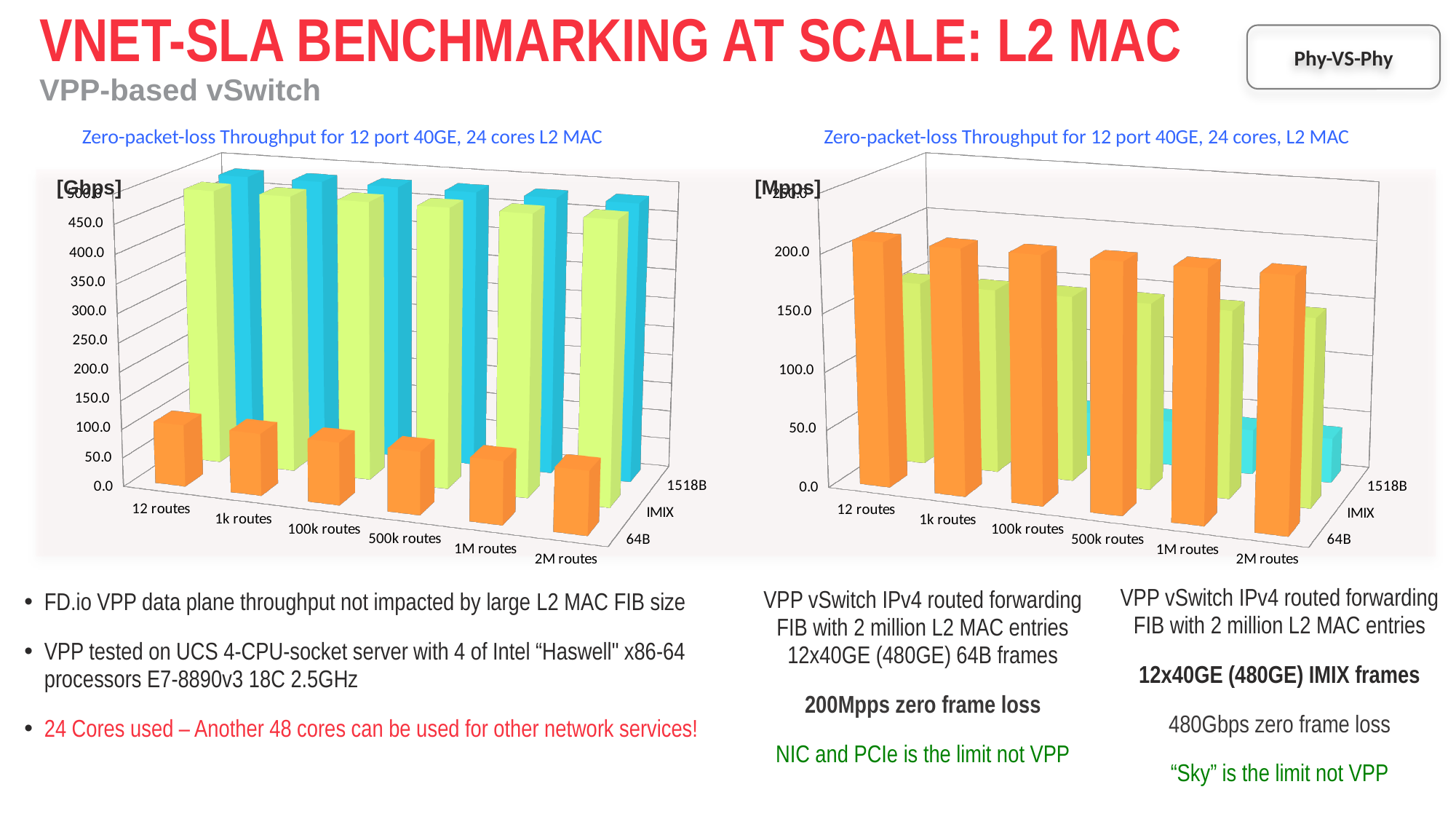
What kind of chart is the left chart, 'Zero-packet-loss Throughput for 12 port 40GE, 24 cores L2 MAC'? bar chart In the right chart (Mpps), which frame-size series has the highest values across all route counts? 64B In the left chart (Gbps), is the value for 1518B at 12 routes greater or less than 400? greater In the right chart (Mpps), how many frame-size series are plotted? 3 In the left chart (Gbps), how many route-count categories are shown along the x axis? 6 In the left chart (Gbps), which frame-size series has the lowest values across all route counts? 64B In the left chart (Gbps), is the value for 64B at 12 routes greater or less than 200? less In the right chart (Mpps), which is larger at 12 routes: 64B or 1518B? 64B In the right chart (Mpps), do the 64B values rise or fall from 12 routes to 2M routes? Neither; they stay flat (constant across all route counts) What unit is shown on the vertical axis of the right chart? [Mpps] In the right chart (Mpps), is the value for 64B at 12 routes greater or less than 150? greater